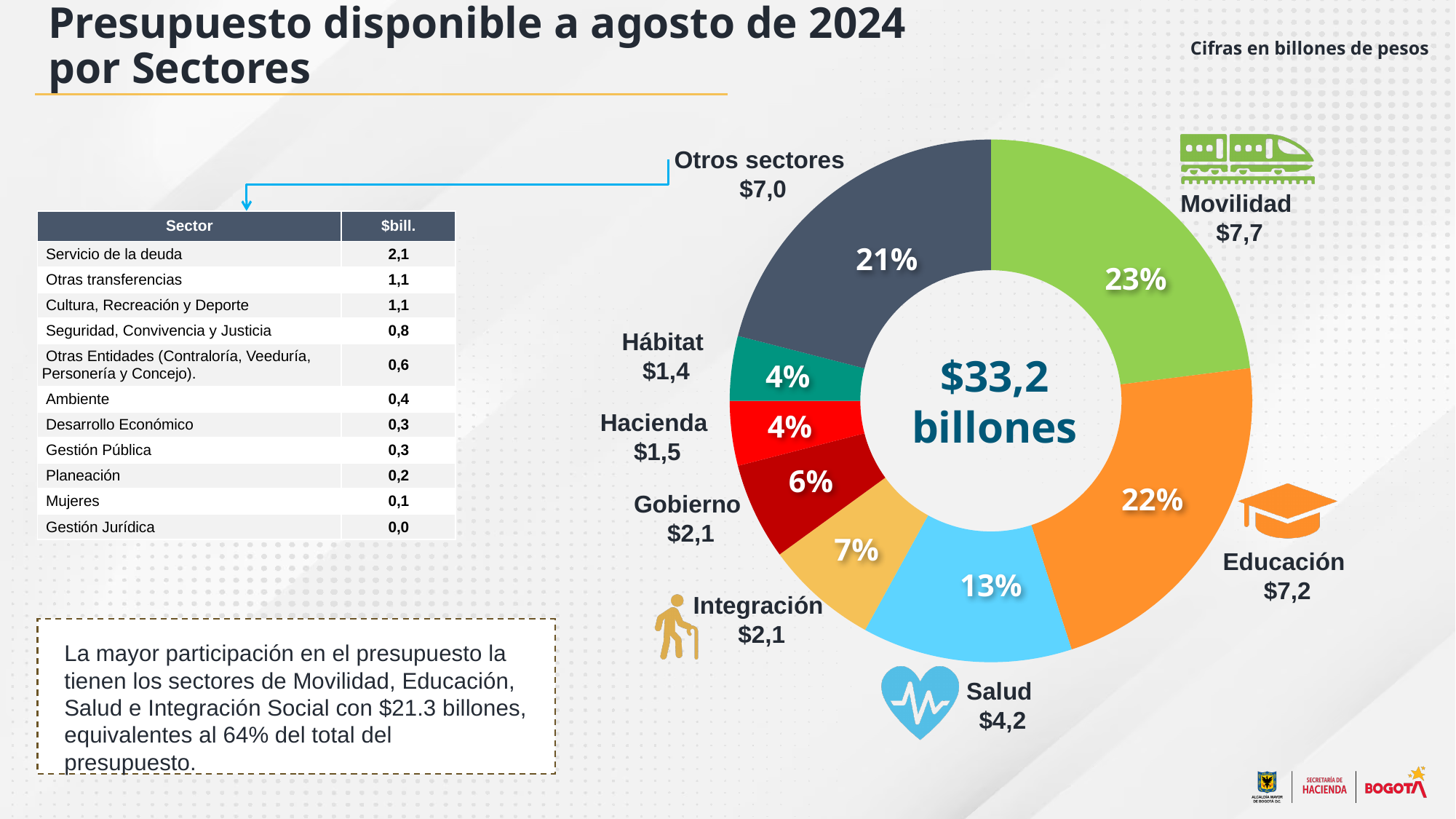
How many slices does the donut chart have? 8 What kind of chart is shown on the slide? Pie chart (donut) Which sector has the largest share of the budget in the donut chart? Movilidad What total value is shown in the centre of the donut chart? $33,2 billones What is the value shown for Movilidad in the donut chart? $7,7 Which is larger, the value for Hacienda or the value for Hábitat? Hacienda What is the value shown for Gobierno? $2,1 What is the value shown for Salud? $4,2 What percentage share does Integración have in the donut chart? 7% What is the difference between the values for Movilidad and Educación? $0,5 What percentage share does Educación have in the donut chart? 22% What percentage share does Otros sectores have? 21%